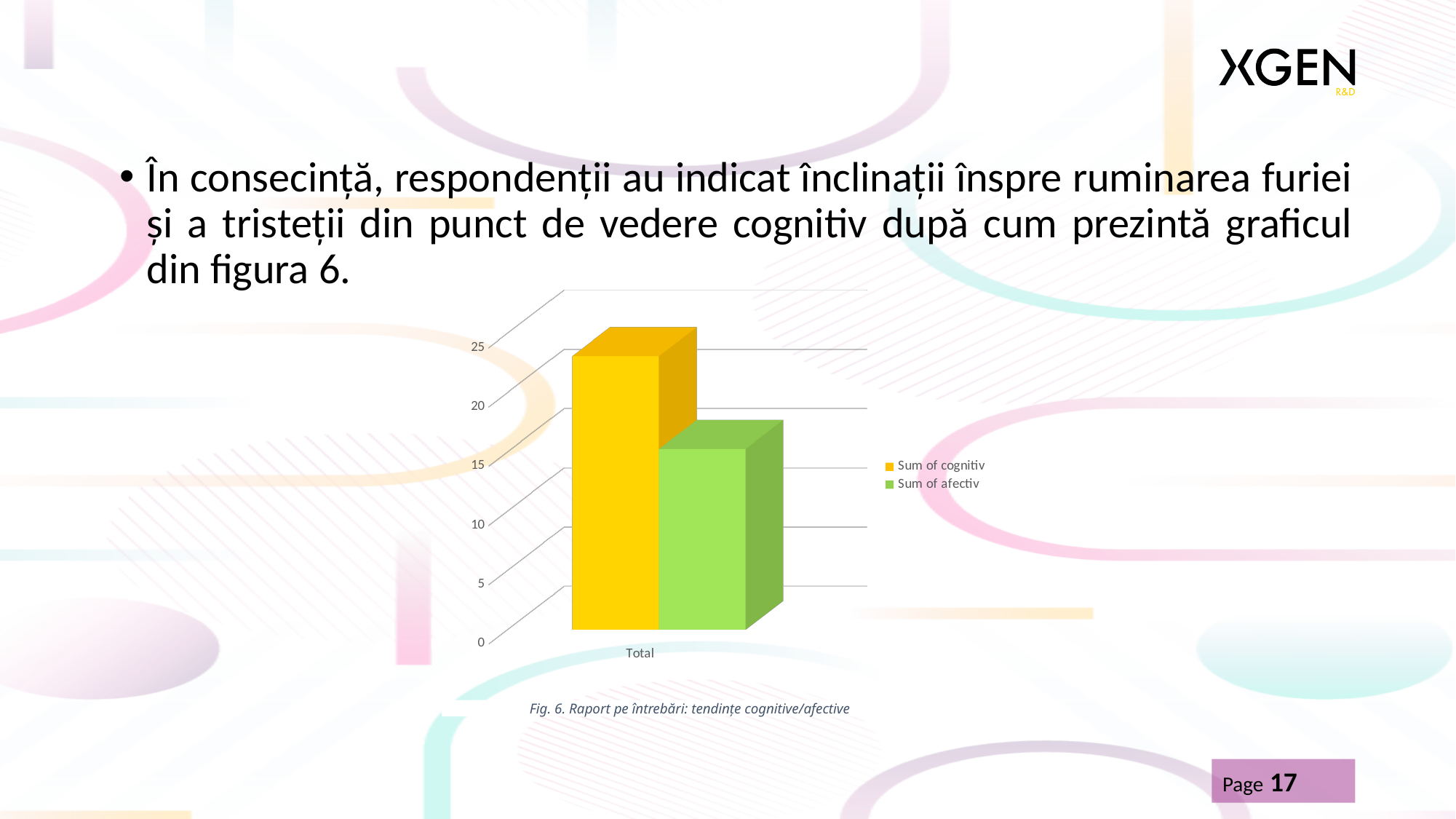
Which series has the taller bar, Sum of cognitiv or Sum of afectiv? Sum of cognitiv Is the value for Sum of afectiv greater or less than 20? less What kind of chart is shown on the slide? bar chart How many categories are shown on the x axis of the chart? 1 Is the value for Sum of afectiv greater or less than 10? greater What is the highest tick value shown on the vertical axis of the chart? 25 What is the label of the single category on the x axis? Total Is the value for Sum of cognitiv greater or less than 20? greater How many series does the chart's legend list? 2 What colour is the bar for Sum of afectiv? green Which series has the highest value in the chart? Sum of cognitiv Which series has the lowest value in the chart? Sum of afectiv